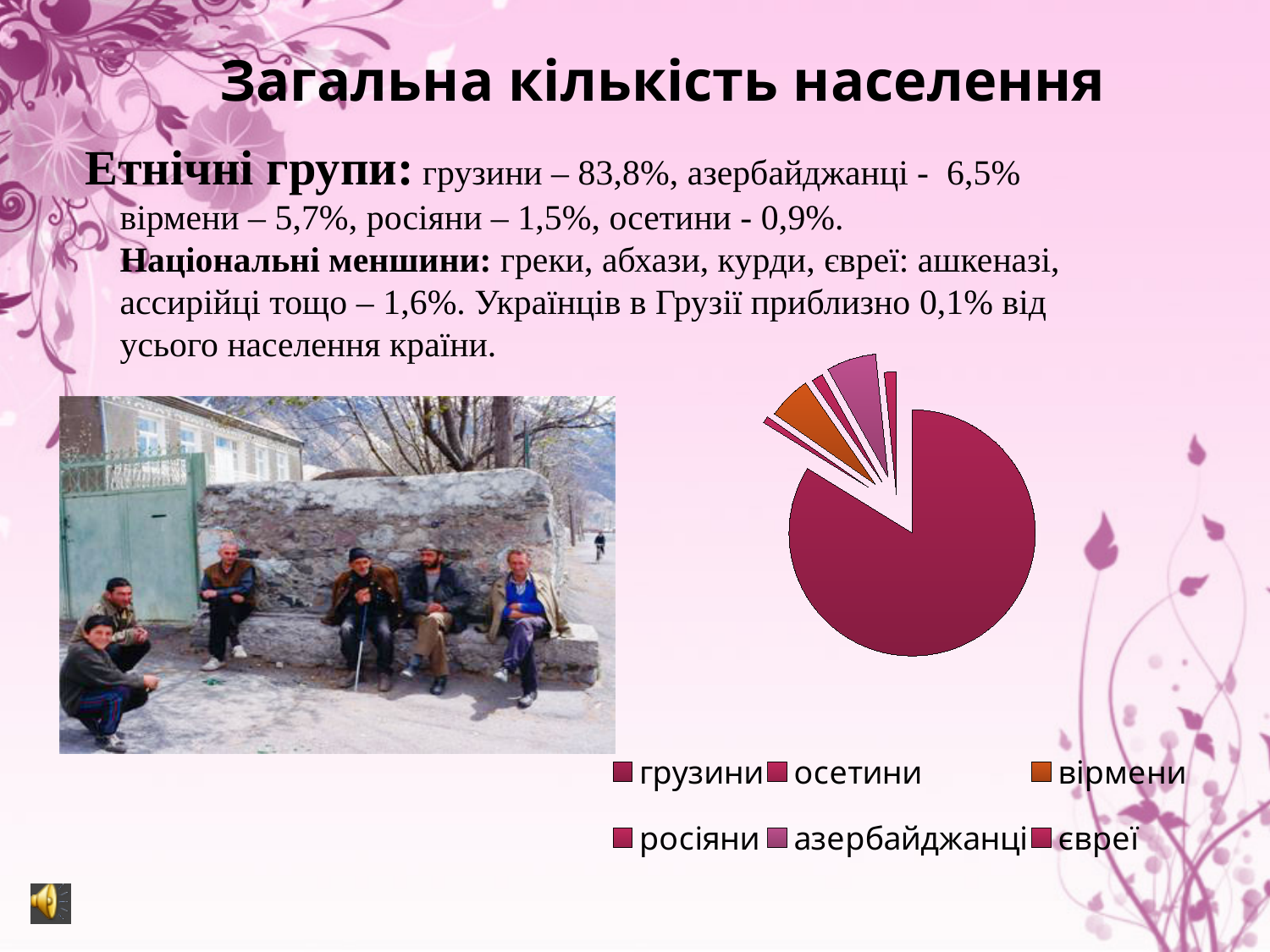
Which category has the largest slice in the pie chart? грузини Which legend entry of the pie chart is shown in orange? вірмени What kind of chart is shown on the slide? pie chart How many categories does the legend of the pie chart list? 6 Which legend entry appears first in the pie chart's legend? грузини Is the slice for грузини larger or smaller than the slice for вірмени? larger Does the slice for грузини take up more or less than half of the pie? more